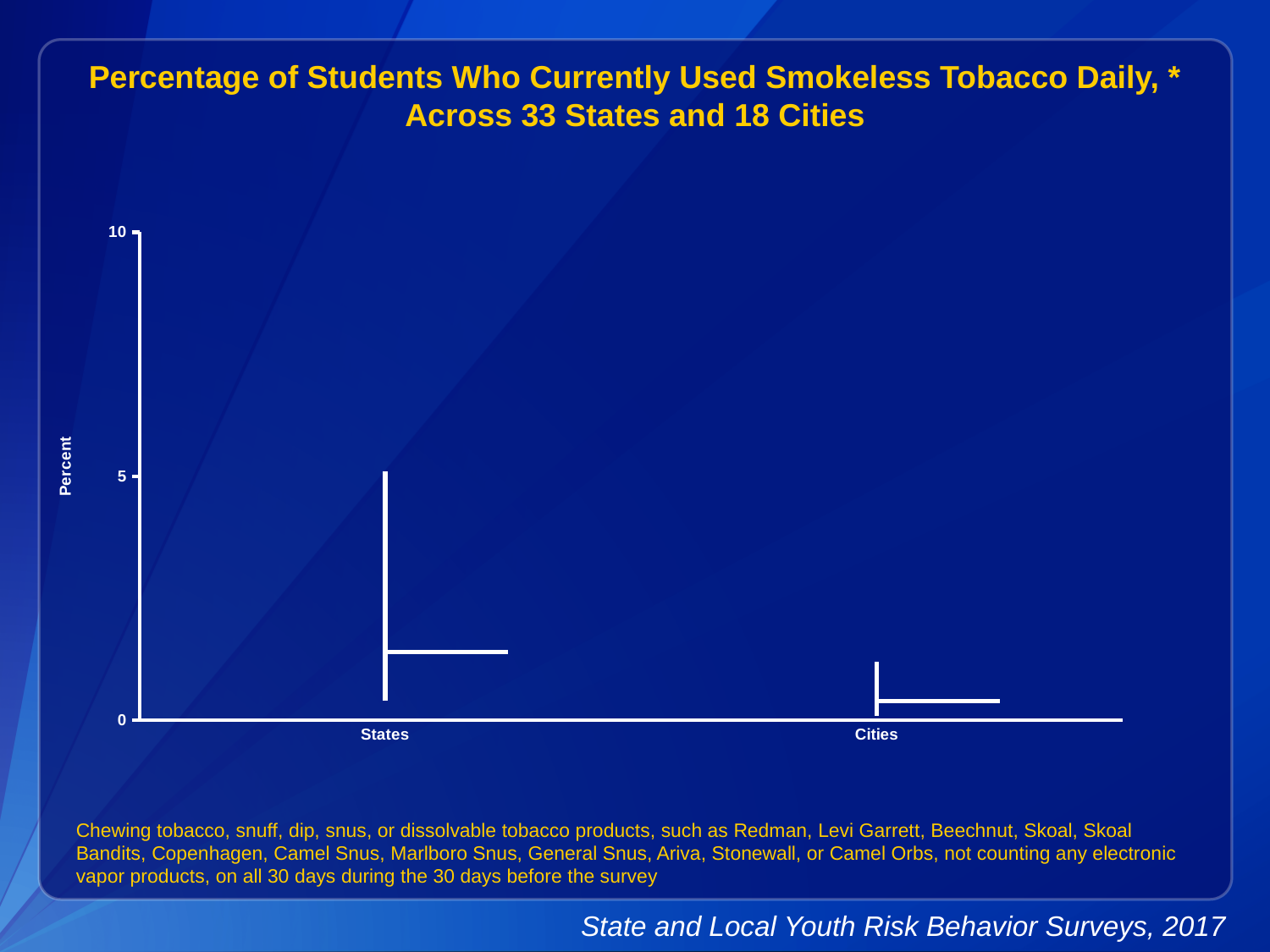
Is the median value (horizontal mark) for Cities greater or less than 5? less Which category has the higher top of its range, States or Cities? States Is the median value (horizontal mark) for States greater or less than 5? less What are the two categories shown on the x axis of the chart? States and Cities Which category has the higher median value (horizontal mark), States or Cities? States What is the label on the y axis of the chart? Percent Is the top of the range for Cities greater or less than 5? less How many categories are shown on the x axis of the chart? 2 Which category has the lower median value (horizontal mark)? Cities What is the highest value shown on the y axis of the chart? 10